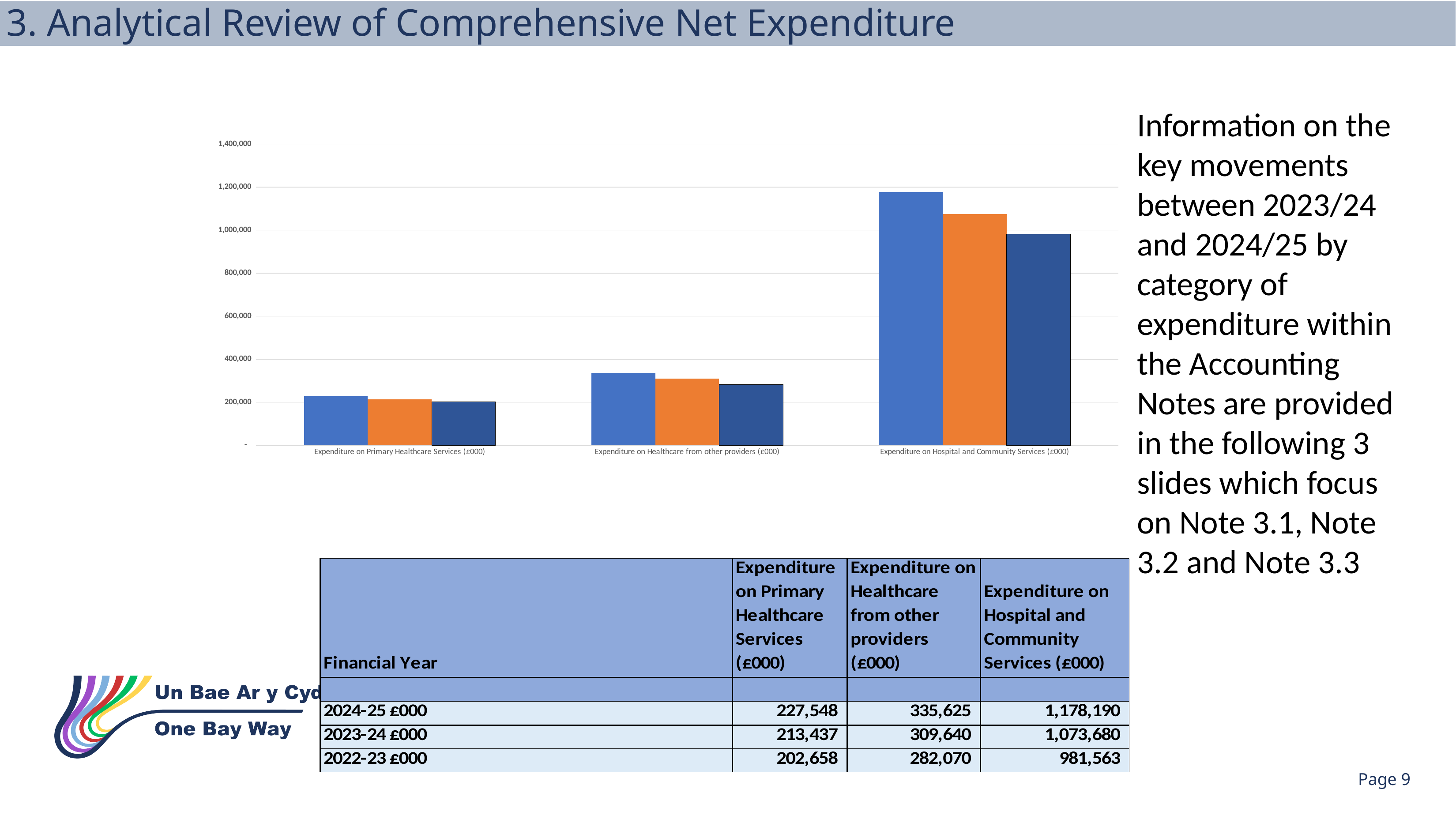
Which is larger: Expenditure on Healthcare from other providers (£000) in 2024-25 or in 2023-24? 2024-25 According to the data table, what was Expenditure on Primary Healthcare Services (£000) in 2024-25? 227,548 According to the data table, what was Expenditure on Hospital and Community Services (£000) in 2022-23? 981,563 Which expenditure category has the shortest bars in the chart? Expenditure on Primary Healthcare Services (£000) Is the tallest bar for Expenditure on Hospital and Community Services (£000) greater or less than 1,000,000? greater Do the bar heights rise or fall moving from left to right across the three categories on the x axis? rise By how much did Expenditure on Hospital and Community Services (£000) increase from 2023-24 to 2024-25? 104,510 How many bars are plotted for each expenditure category in the chart? 3 What is the difference between Expenditure on Primary Healthcare Services (£000) in 2024-25 and in 2022-23? 24,890 What kind of chart is shown on the slide? bar chart How many expenditure categories are shown along the x axis of the chart? 3 Which expenditure category has the tallest bars in the chart? Expenditure on Hospital and Community Services (£000)